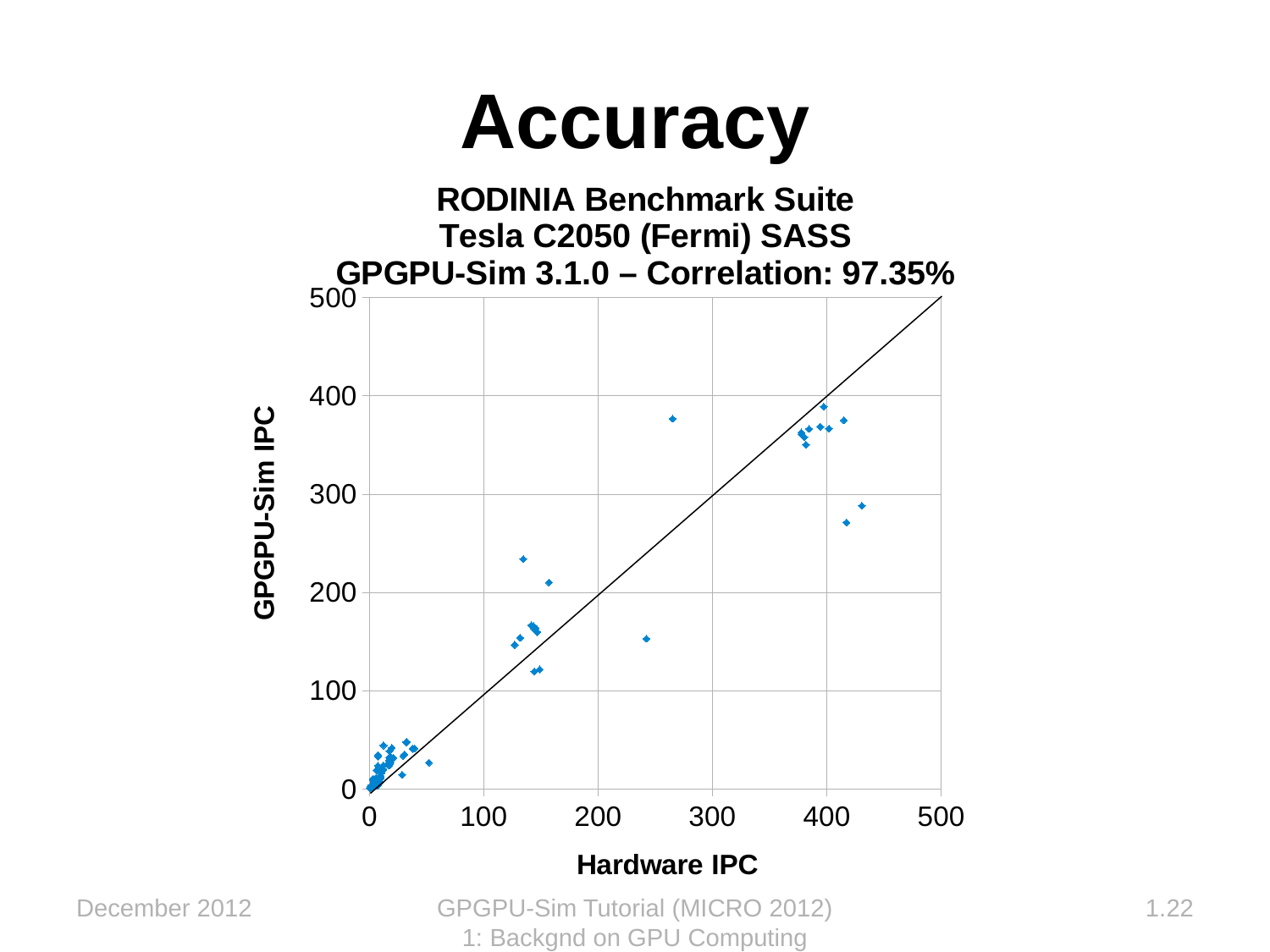
What is the highest tick value shown on the Hardware IPC axis? 500 Is the Hardware IPC of the point with the highest GPGPU-Sim IPC greater or less than 300? greater What correlation value is reported in the chart title? 97.35% What kind of chart is shown on the slide? scatter chart Is the GPGPU-Sim IPC of the point with Hardware IPC closest to 240 greater or less than 200? less Do the plotted points generally rise or fall as Hardware IPC increases? rise Is the GPGPU-Sim IPC of the point with the highest Hardware IPC greater or less than 350? less What is the highest tick value shown on the GPGPU-Sim IPC axis? 500 What is the title of the horizontal axis? Hardware IPC Which benchmark suite is named in the chart title? RODINIA Benchmark Suite